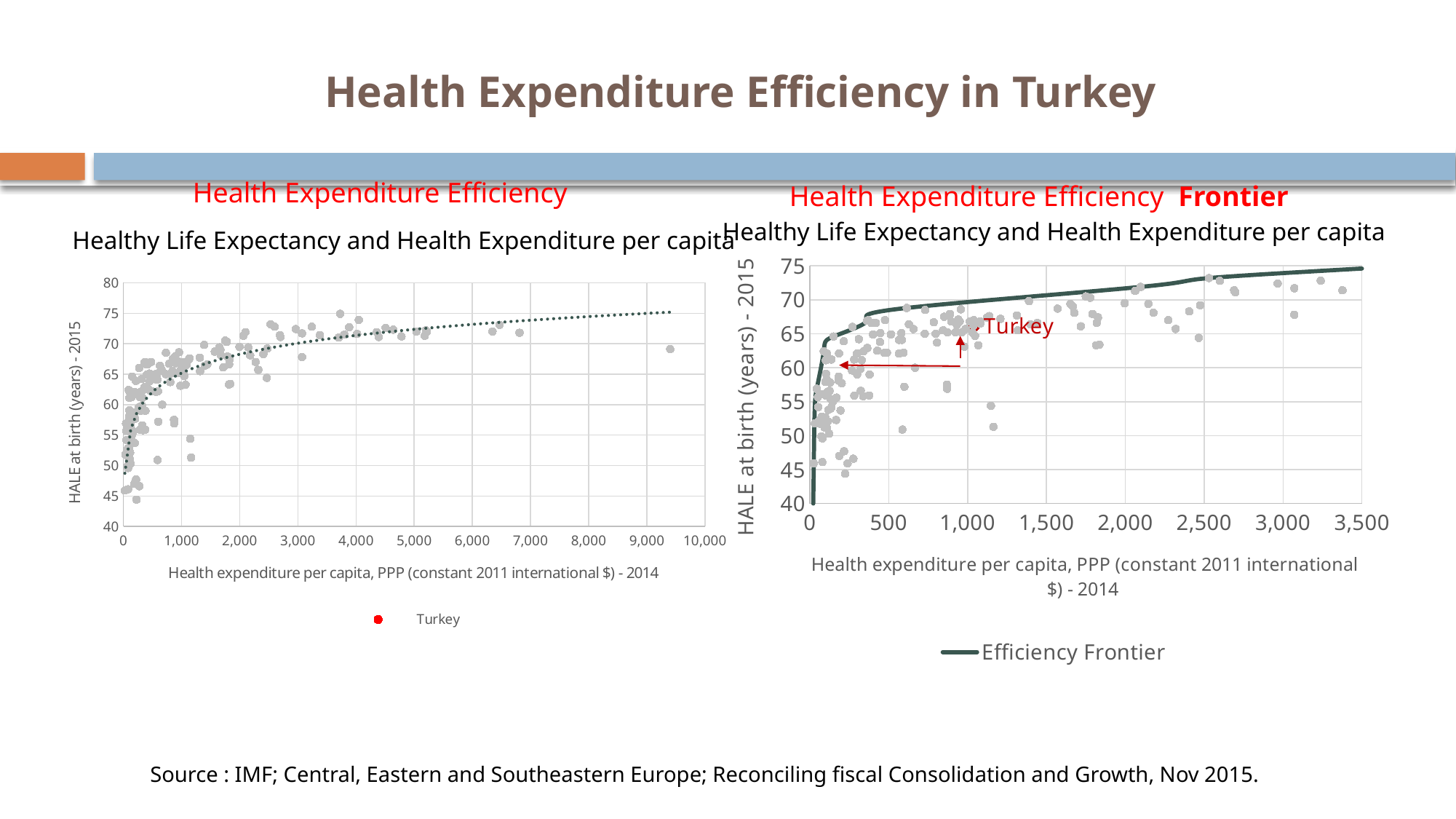
In the right chart, does the Efficiency Frontier line rise or fall as health expenditure per capita increases? Rise How many series does the legend of the right chart list? 1 How many series does the legend of the left chart list? 1 In the right chart, is the health expenditure per capita for the point labelled Turkey greater or less than 1,500? less What is the maximum value shown on the x axis of the right chart? 3,500 What is the maximum value shown on the x axis of the left chart? 10,000 In the right chart, is the HALE value for the point labelled Turkey greater or less than 70? less In the right chart, is the HALE value for the point labelled Turkey greater or less than 60? greater What kind of chart is the right chart under 'Health Expenditure Efficiency Frontier'? Scatter chart What kind of chart is the left chart titled 'Healthy Life Expectancy and Health Expenditure per capita'? Scatter chart In the left chart, do HALE values generally rise or fall as health expenditure per capita increases along the x axis? Rise